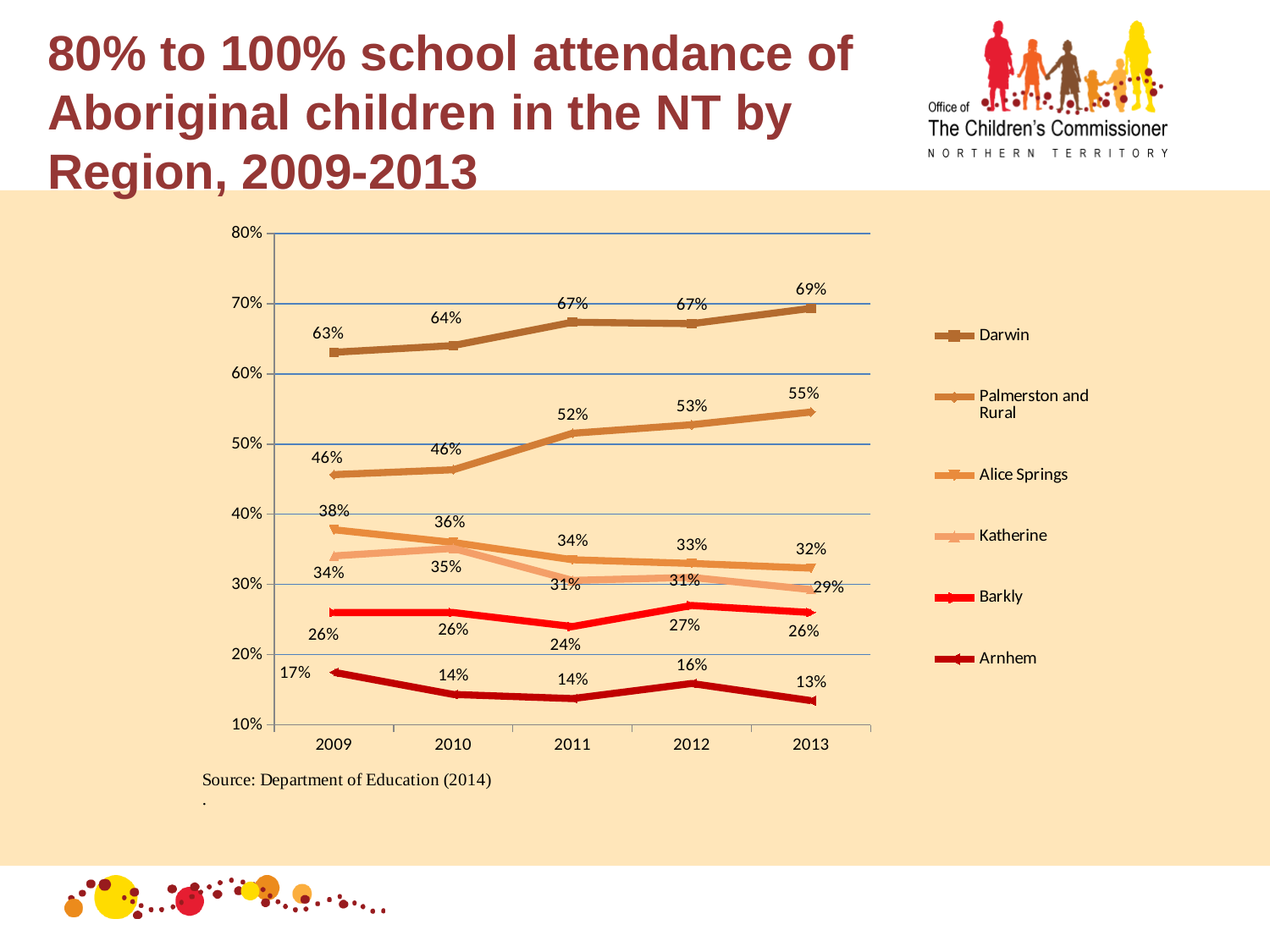
Which region had the lowest value in 2013? Arnhem How many years are shown on the x axis? 5 What was the value for Palmerston and Rural in 2011? 52% What type of chart is shown on the slide? Line chart Did the Alice Springs values rise or fall from 2009 to 2013? Fall Which region had the highest value in 2009? Darwin How many series does the legend list? 6 What was the value for Darwin in 2013? 69% What was the value for Arnhem in 2009? 17% Which was larger in 2010, Alice Springs or Katherine? Alice Springs What is the source cited below the chart? Department of Education (2014) What is the difference between the Darwin and Palmerston and Rural values in 2013? 14 percentage points